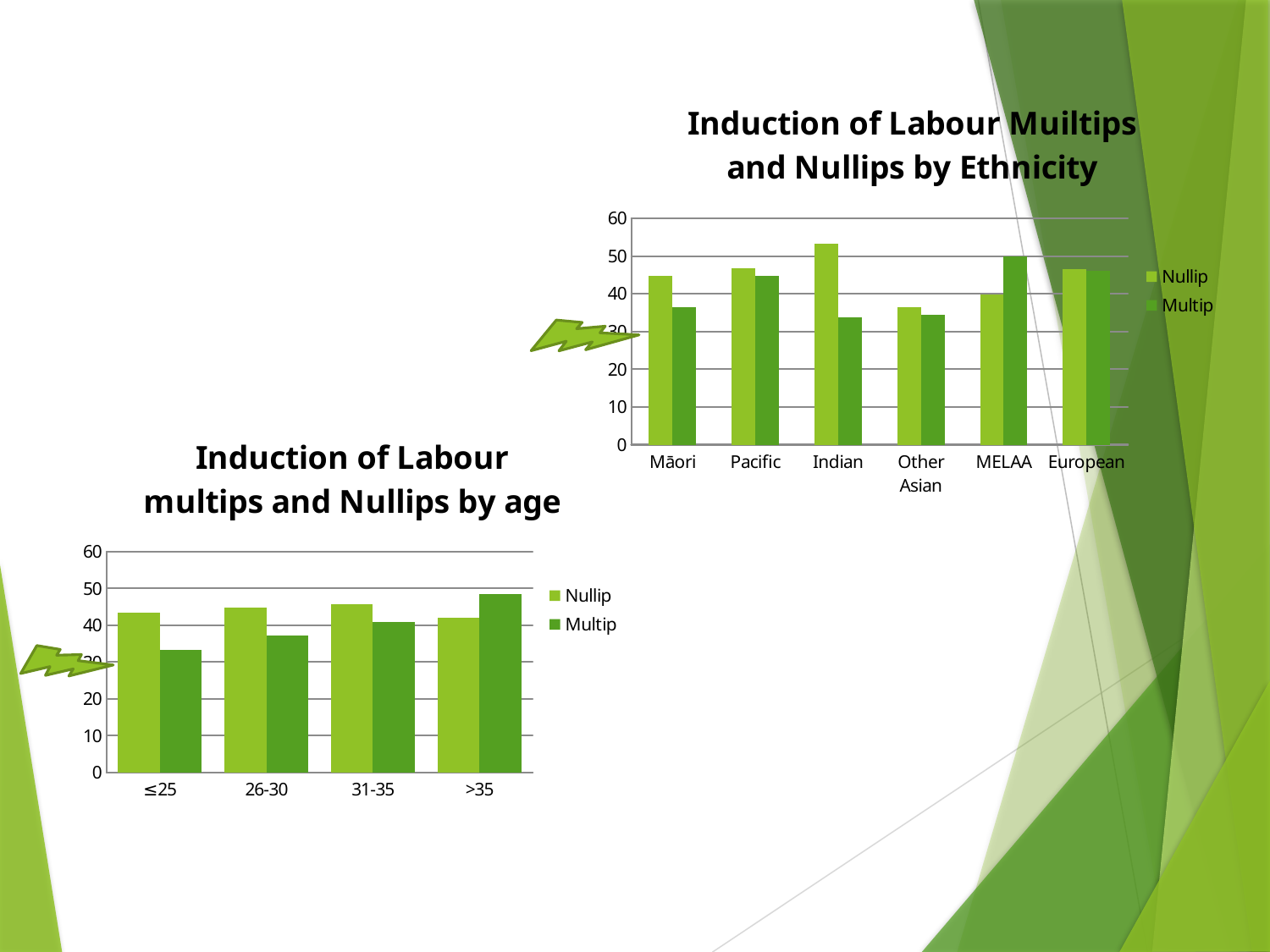
In the 'Induction of Labour Muiltips and Nullips by Ethnicity' chart, which ethnicity has the lowest Nullip value? Other Asian In the 'Induction of Labour multips and Nullips by age' chart, which age group has the highest Multip value? >35 How many ethnicity categories are shown in the 'Induction of Labour Muiltips and Nullips by Ethnicity' chart? 6 In the 'Induction of Labour Muiltips and Nullips by Ethnicity' chart, is the Nullip value for Indian greater or less than 50? greater In the 'Induction of Labour Muiltips and Nullips by Ethnicity' chart, which ethnicity has the highest Multip value? MELAA In the 'Induction of Labour Muiltips and Nullips by Ethnicity' chart, is the Multip value for Māori greater or less than 40? less In the 'Induction of Labour multips and Nullips by age' chart, is the Multip value for ≤25 greater or less than 40? less In the 'Induction of Labour Muiltips and Nullips by Ethnicity' chart, which is larger for Indian: the Nullip value or the Multip value? Nullip In the 'Induction of Labour multips and Nullips by age' chart, which age group has the lowest Multip value? ≤25 How many series does the legend list in the 'Induction of Labour multips and Nullips by age' chart? 2 In the 'Induction of Labour multips and Nullips by age' chart, do the Multip values rise or fall as age increases from ≤25 to >35? rise In the 'Induction of Labour Muiltips and Nullips by Ethnicity' chart, which ethnicity has the highest Nullip value? Indian